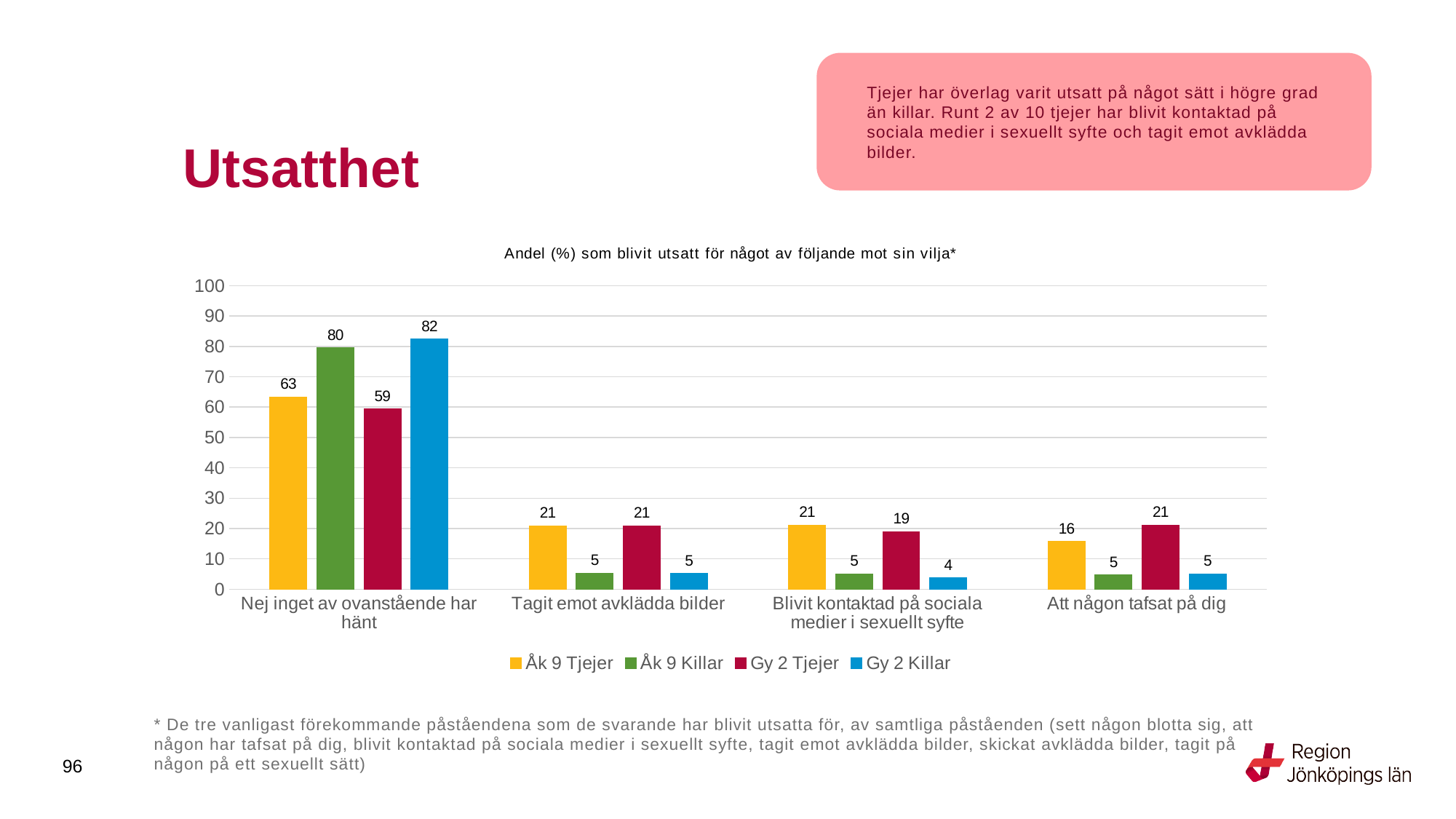
What is the value for Gy 2 Tjejer in the category 'Blivit kontaktad på sociala medier i sexuellt syfte'? 19 What is the value for Åk 9 Tjejer in the category 'Tagit emot avklädda bilder'? 21 Which series has the lowest value in the category 'Blivit kontaktad på sociala medier i sexuellt syfte'? Gy 2 Killar Which series has the highest value in the category 'Nej inget av ovanstående har hänt'? Gy 2 Killar What kind of chart is shown on the slide? Bar chart What is the value for Gy 2 Killar in the category 'Nej inget av ovanstående har hänt'? 82 What is the title of the chart? Andel (%) som blivit utsatt för något av följande mot sin vilja* What is the difference between the Åk 9 Killar and Gy 2 Tjejer values in the category 'Nej inget av ovanstående har hänt'? 21 How many series does the legend list? 4 In the category 'Att någon tafsat på dig', which is larger: the value for Åk 9 Tjejer or Gy 2 Tjejer? Gy 2 Tjejer How many categories are shown on the x axis? 4 What is the value for Åk 9 Tjejer in the category 'Att någon tafsat på dig'? 16